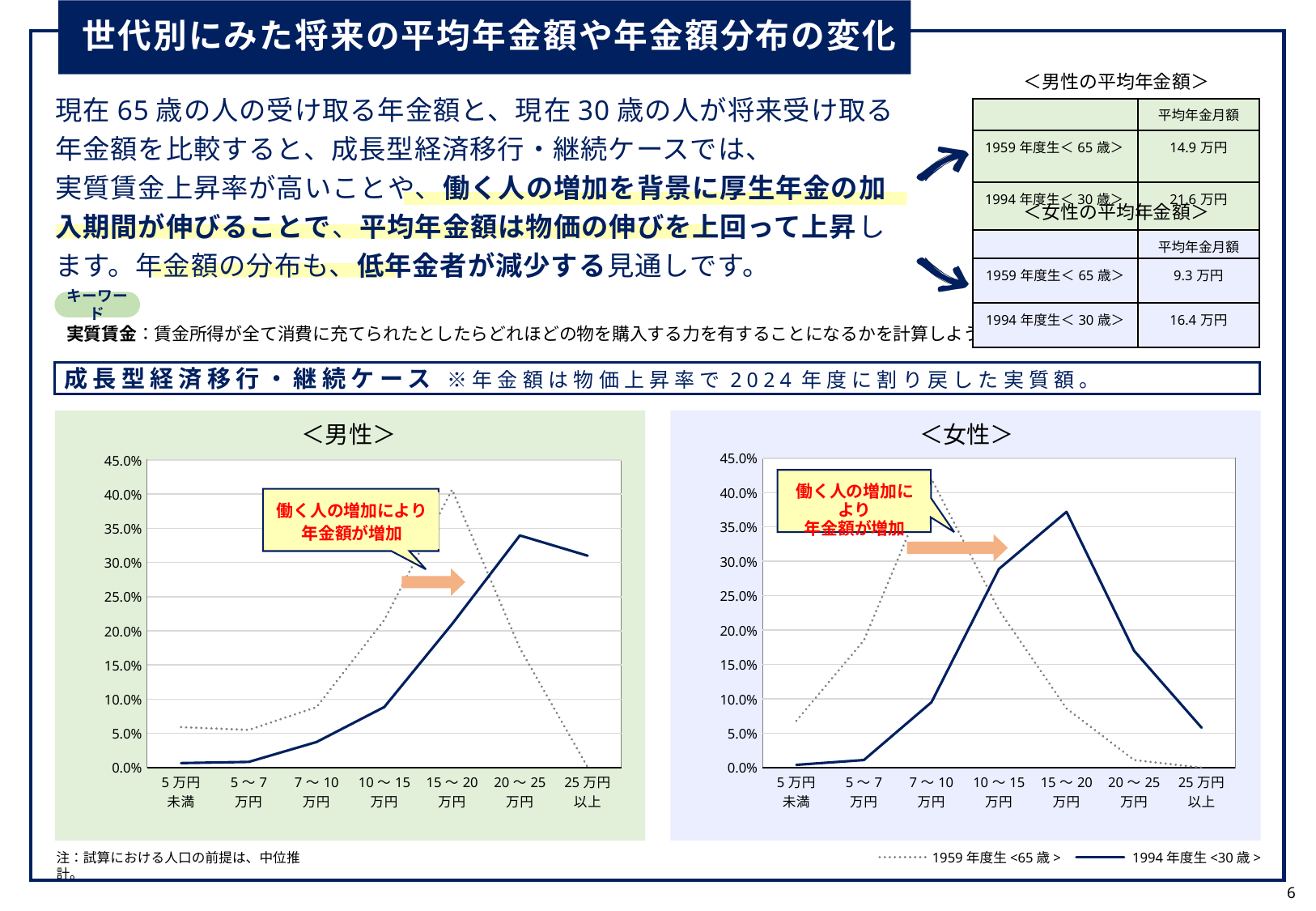
In the <男性> chart, is the value for 1994年度生<30歳> at 20～25万円 greater or less than 30.0%? greater In the <男性> chart, does the 1994年度生<30歳> series rise or fall from 5万円未満 to 20～25万円? rise In the <女性> chart, which category has the highest value for the 1959年度生<65歳> series? 7～10万円 In the <男性> chart, at 20～25万円, which series has the larger value: 1959年度生<65歳> or 1994年度生<30歳>? 1994年度生<30歳> How many categories are shown on the x axis of the <女性> chart? 7 In the <男性> chart, which category has the highest value for the 1994年度生<30歳> series? 20～25万円 In the <男性> chart, which category has the highest value for the 1959年度生<65歳> series? 15～20万円 In the <男性> chart, is the value for 1994年度生<30歳> at 5万円未満 greater or less than 5.0%? less How many series does the legend list for the charts? 2 In the <女性> chart, at 15～20万円, which series has the larger value: 1959年度生<65歳> or 1994年度生<30歳>? 1994年度生<30歳> What kind of chart is the <男性> chart? line chart